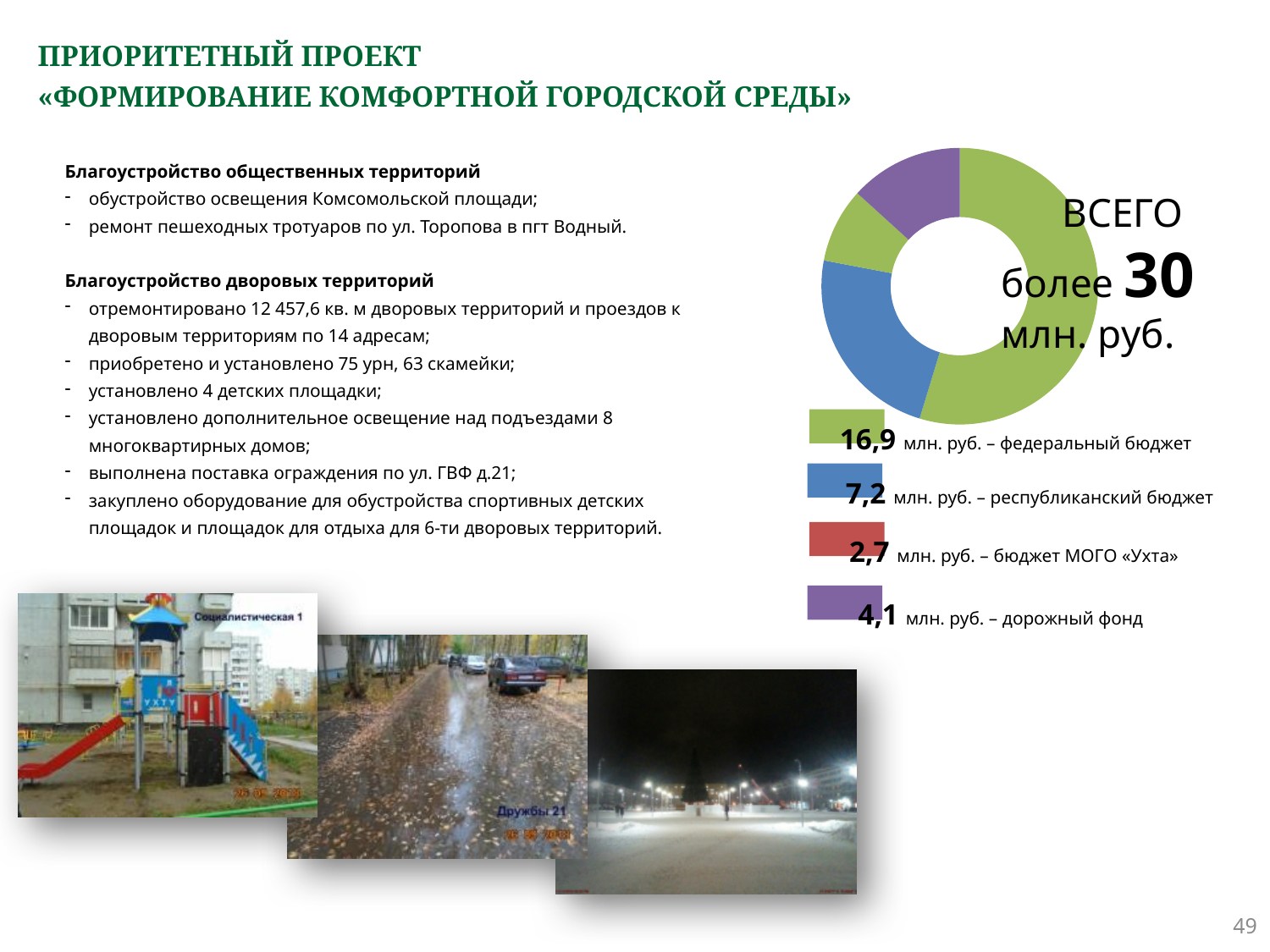
By how many million rubles does the federal budget exceed the republican budget? 9,7 Which is larger: the republican budget or the road fund? республиканский бюджет How many funding sources are shown in the chart? 4 Which funding source has the smallest value in the chart? бюджет МОГО «Ухта» What value is shown for the road fund (дорожный фонд)? 4,1 млн. руб. How many million rubles came from the federal budget according to the chart? 16,9 Which funding source has the largest value in the chart? федеральный бюджет What value is shown for the republican budget (республиканский бюджет)? 7,2 млн. руб. What amount is attributed to the budget of МОГО «Ухта»? 2,7 млн. руб. What type of chart is used to show the funding sources? Pie (donut) chart What total amount does the chart state in its centre? более 30 млн. руб. What is the difference between the road fund and the МОГО «Ухта» budget, in million rubles? 1,4